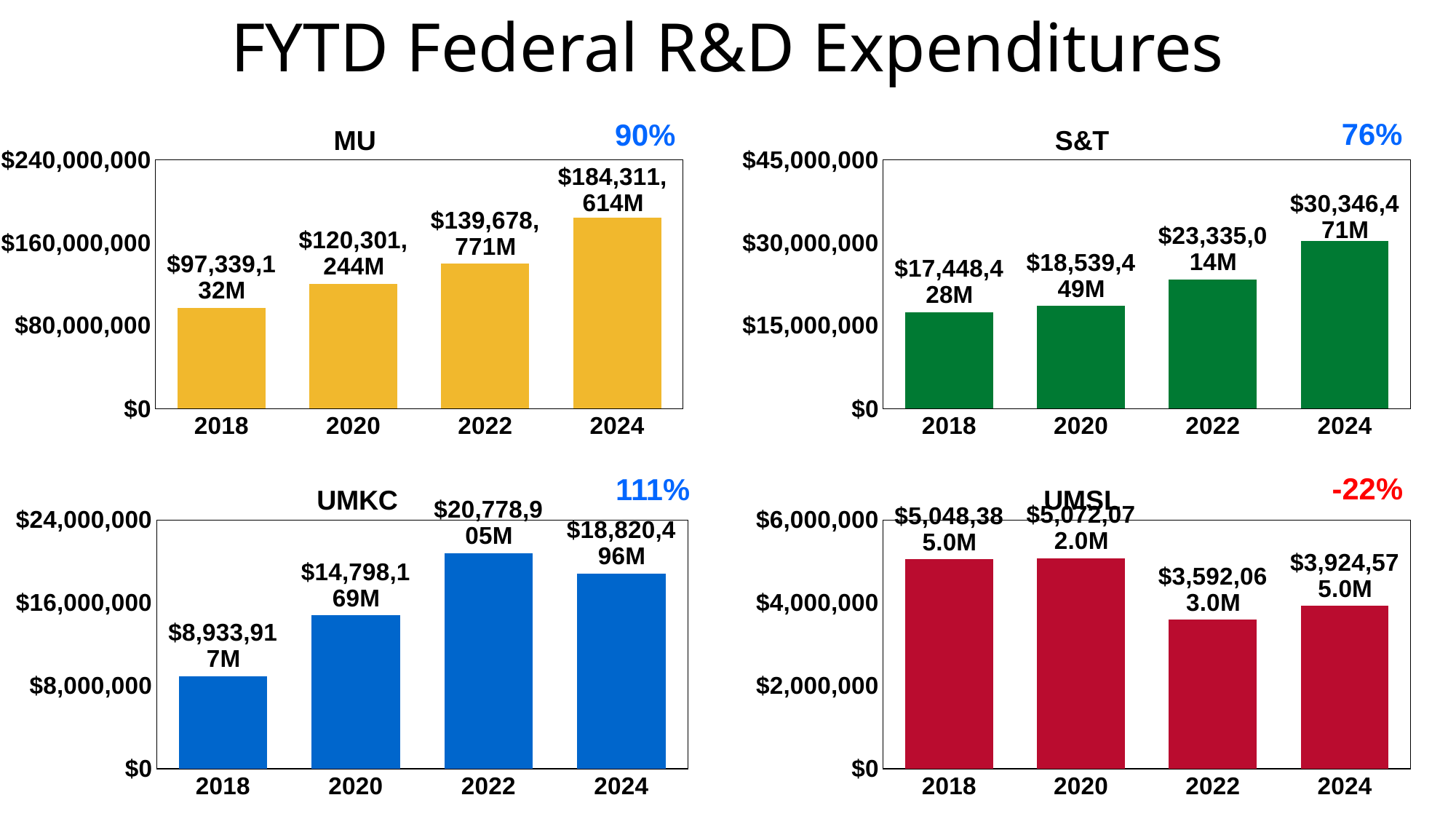
In the MU chart, what is the difference between the 2024 value and the 2022 value? $44,632,843M In the UMSL chart, what is the value for 2024? $3,924,575.0M What percentage is shown in red above the UMSL chart? -22% In the UMSL chart, which year has the lowest value? 2022 In the MU chart, do the values rise or fall from 2018 to 2024? rise In the UMKC chart, what is the value for 2018? $8,933,917M In the UMKC chart, which year has the highest value? 2022 How many bar charts are shown on the slide? 4 In the MU chart, what is the value for 2024? $184,311,614M In the MU chart, is the value for 2018 greater or less than $80,000,000? greater In the UMKC chart, which is larger, the value for 2022 or the value for 2024? 2022 In the S&T chart, what is the value for 2022? $23,335,014M